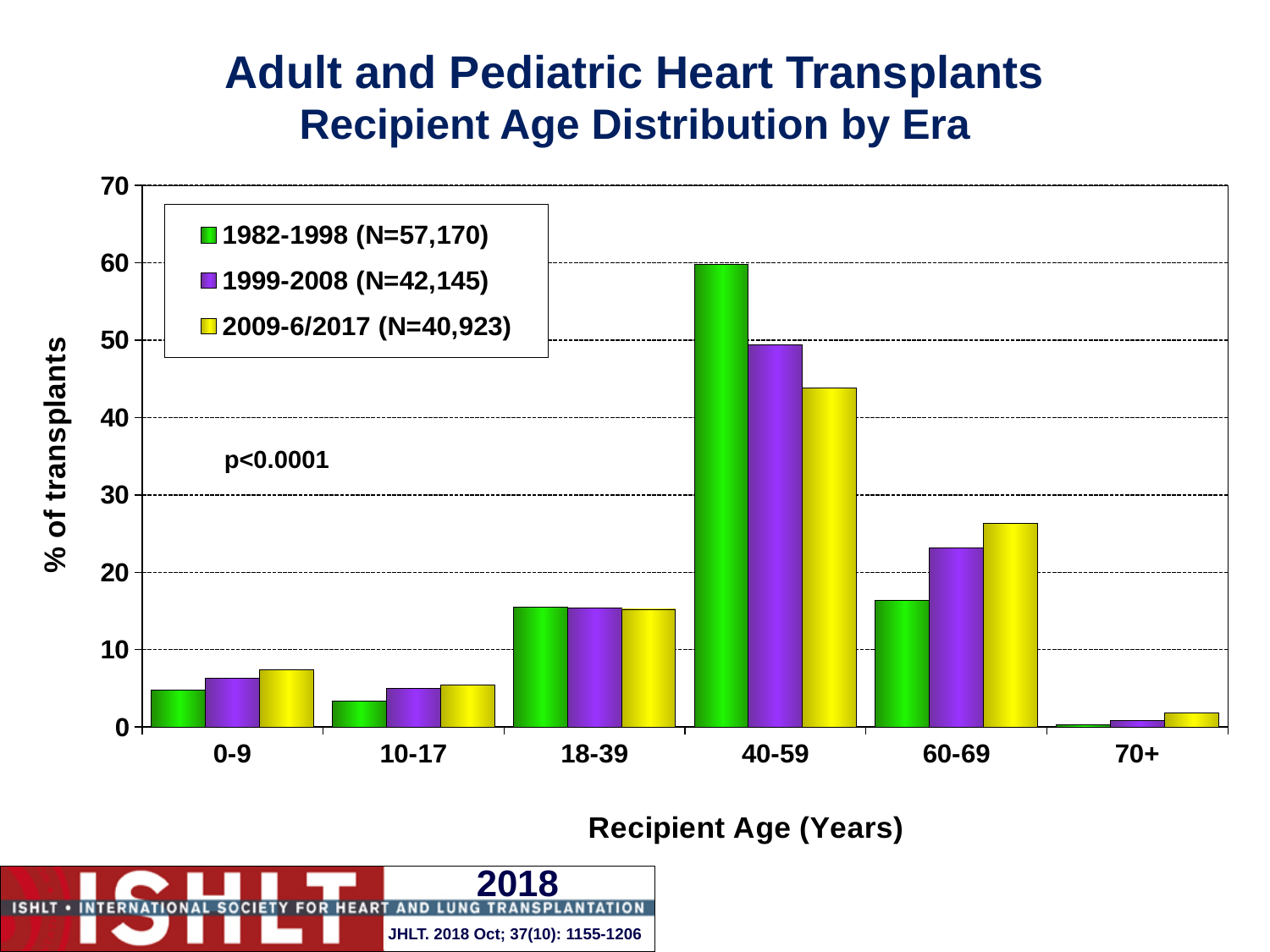
In the 60-69 age group, which era has the larger percentage: 1982-1998 or 2009-6/2017? 2009-6/2017 Is the value for the 1999-2008 era in the 60-69 age group greater or less than 20? greater According to the legend, what is the N for the 1982-1998 era? 57,170 What kind of chart is shown on the slide? Bar chart What is the label of the y axis? % of transplants For the 1982-1998 era, which recipient age group has the lowest percentage of transplants? 70+ How many recipient age categories are shown on the x axis? 6 How many series does the legend list? 3 For the 1982-1998 era, which recipient age group has the highest percentage of transplants? 40-59 Is the value for the 1982-1998 era in the 40-59 age group greater or less than 50? greater In the 40-59 age group, which era has the larger percentage: 1982-1998 or 1999-2008? 1982-1998 Is the value for the 2009-6/2017 era in the 40-59 age group greater or less than 50? less